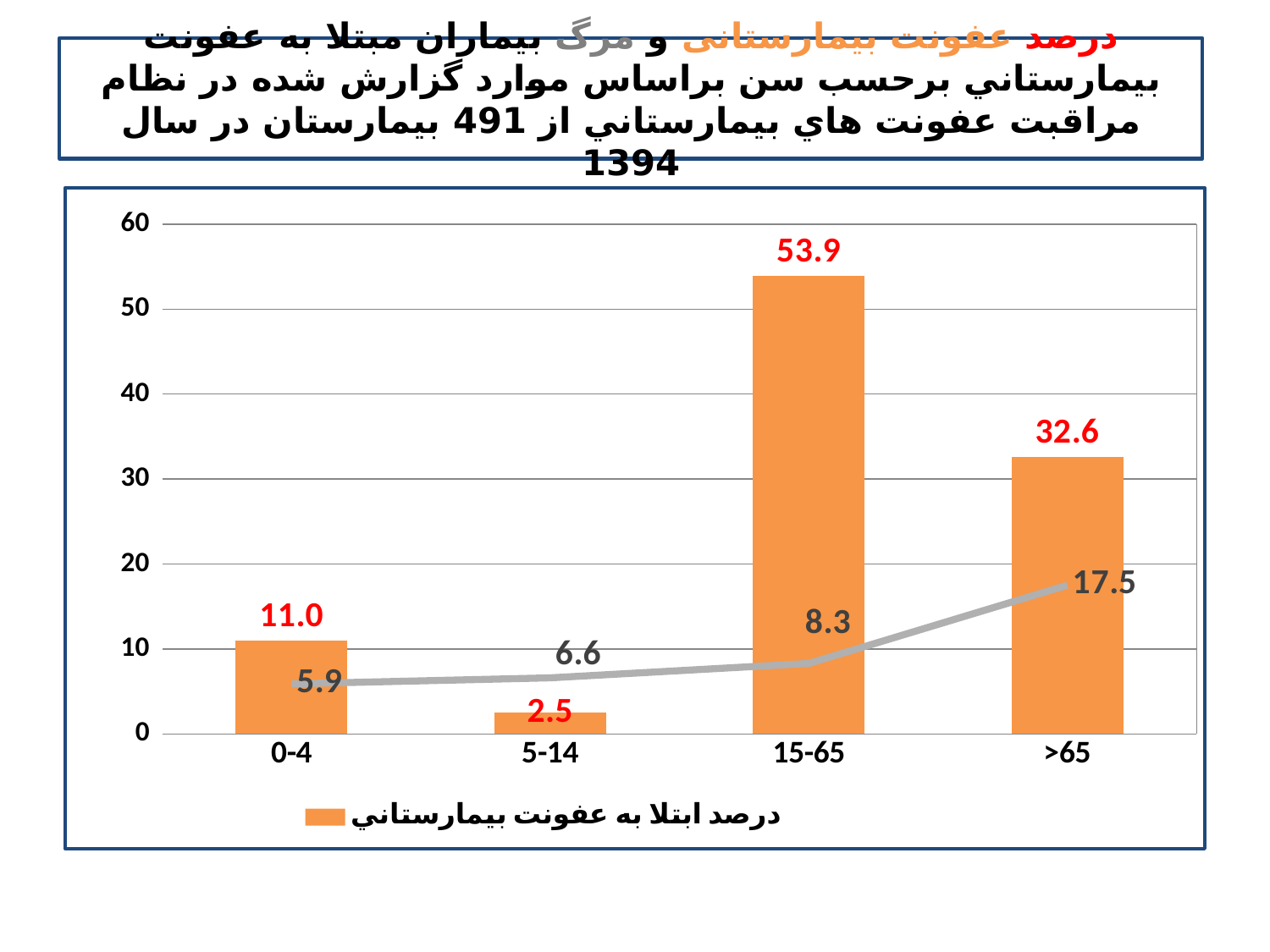
What is the difference between the orange bar values for 15-65 and >65? 21.3 Which age group has the highest orange bar? 15-65 How many age-group categories are shown on the x axis? 4 Does the gray line rise or fall from 0-4 to >65? rise What is the value of the orange bar for the 15-65 age group? 53.9 What is the value of the gray line at the 0-4 age group? 5.9 Which is larger, the orange bar for 0-4 or the orange bar for 5-14? 0-4 What colour are the bars in the chart? orange Which age group has the lowest orange bar? 5-14 What is the value of the orange bar for the 5-14 age group? 2.5 How many series does the legend list? 1 What is the value of the gray line at the >65 age group? 17.5